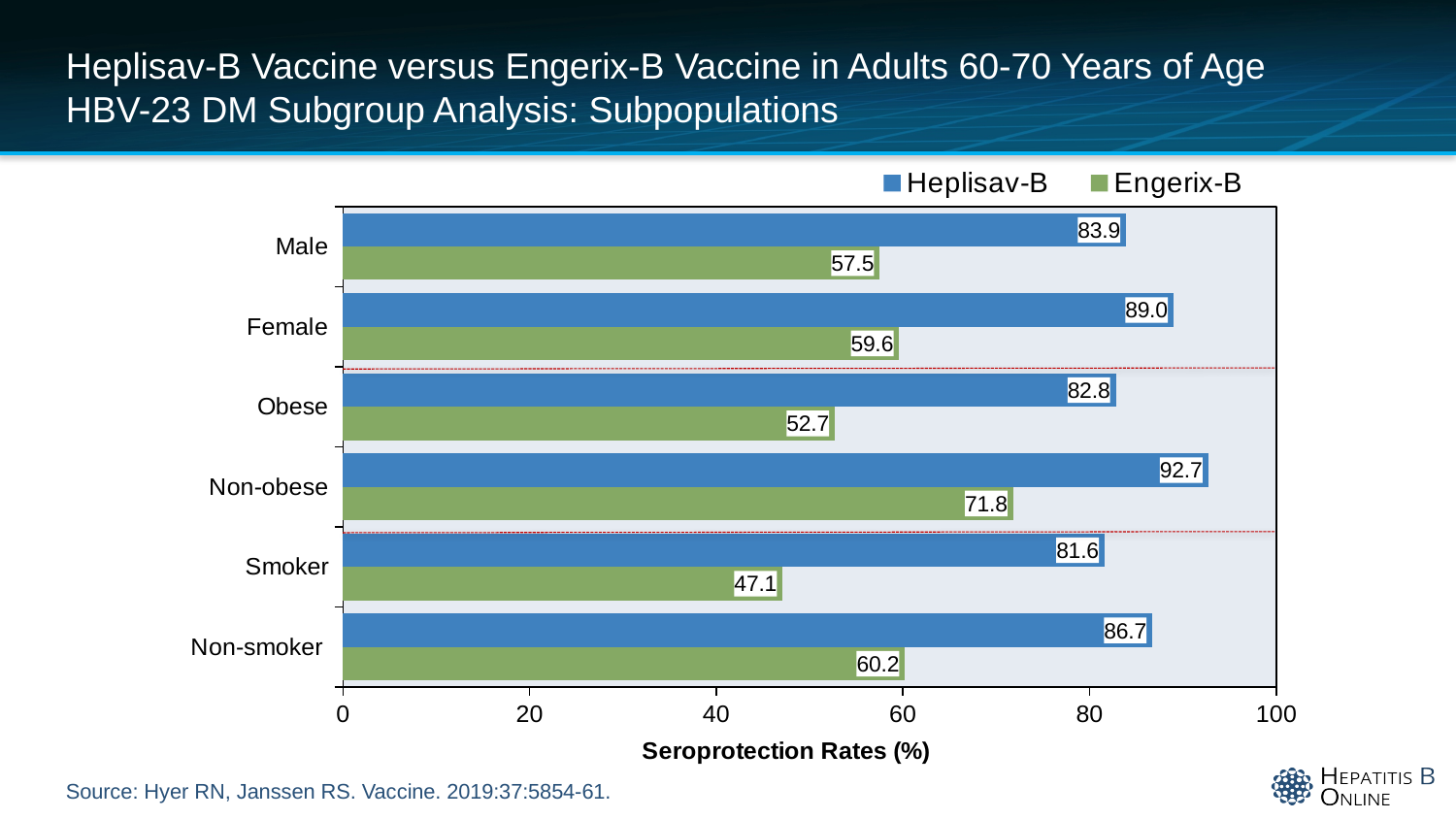
Is the Heplisav-B value for Smoker greater or less than 80? greater Which subgroup has the highest Heplisav-B seroprotection rate? Non-obese What is the Engerix-B seroprotection rate for the Smoker subgroup? 47.1 What is the Heplisav-B seroprotection rate for the Male subgroup? 83.9 How many subgroups are shown on the chart? 6 How many series does the legend list? 2 Which subgroup has the lowest Engerix-B seroprotection rate? Smoker What is the label of the x axis? Seroprotection Rates (%) What kind of chart is shown on the slide? Bar chart What is the difference between the Heplisav-B and Engerix-B seroprotection rates for the Obese subgroup? 30.1 What is the Engerix-B seroprotection rate for the Non-obese subgroup? 71.8 Which is larger, the Engerix-B rate for Female or the Engerix-B rate for Male? Female